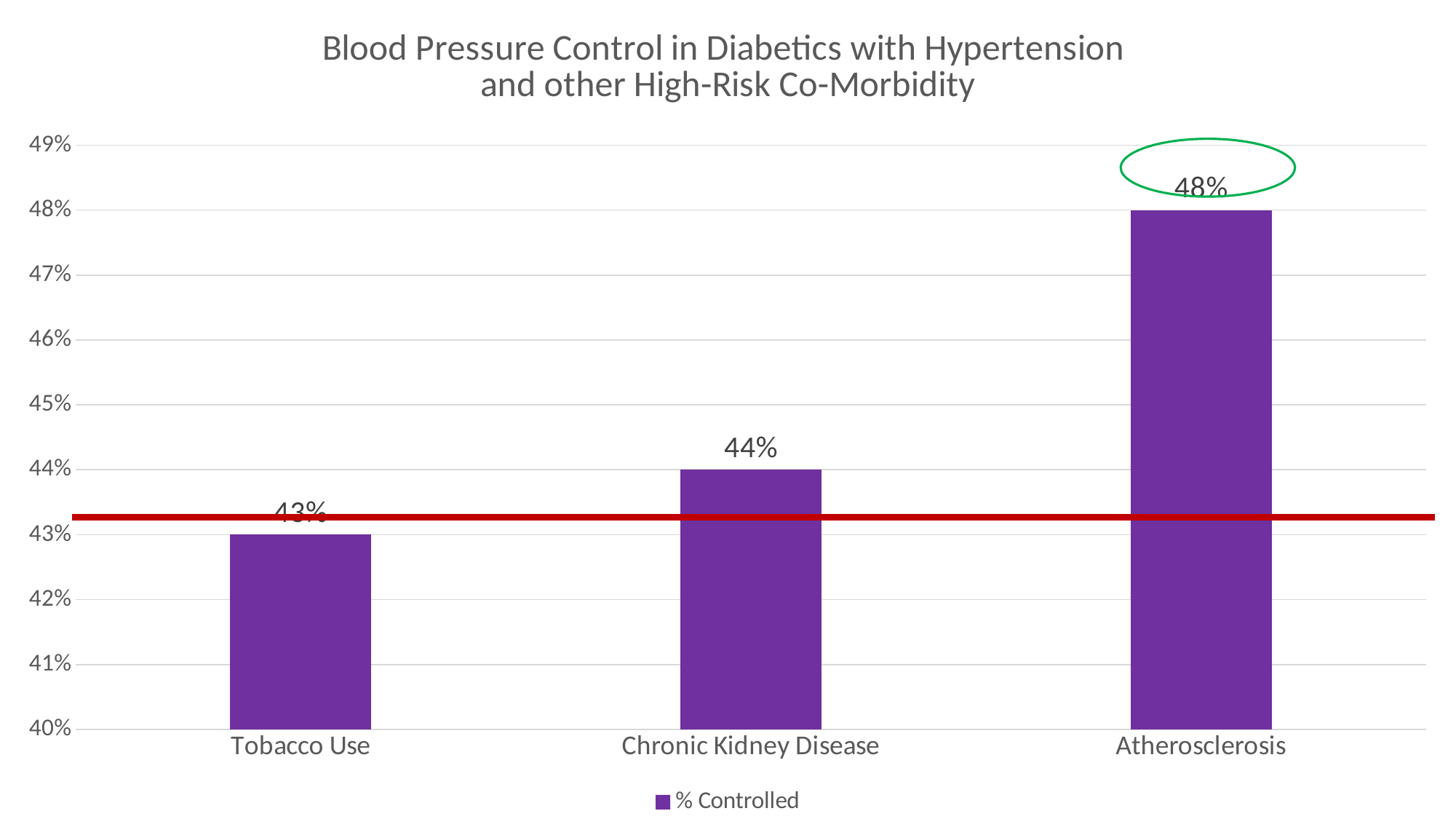
What is the difference in % Controlled between Atherosclerosis and Tobacco Use? 5% What is the % Controlled value for Atherosclerosis? 48% Is the value for Atherosclerosis greater or less than 45%? greater Which has a higher % Controlled, Chronic Kidney Disease or Atherosclerosis? Atherosclerosis What kind of chart is shown on the slide? bar chart What series name is listed in the legend? % Controlled How many categories are shown on the x axis? 3 Which category has the highest % Controlled? Atherosclerosis What is the difference in % Controlled between Atherosclerosis and Chronic Kidney Disease? 4% What is the % Controlled value for Chronic Kidney Disease? 44% What is the % Controlled value for Tobacco Use? 43% Which category has the lowest % Controlled? Tobacco Use